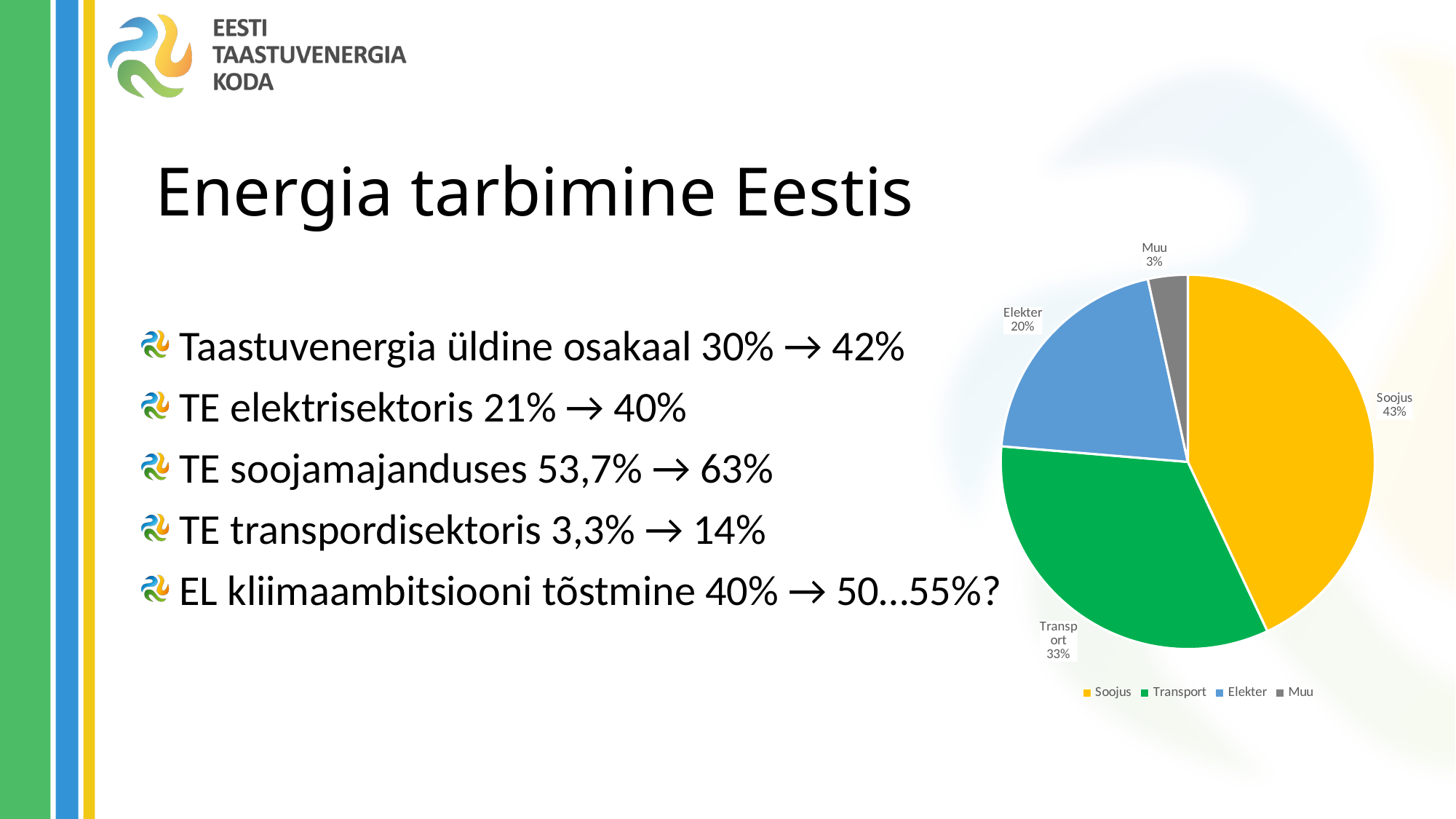
What colour is the Soojus slice in the pie chart? yellow Which category has the smallest slice of the pie? Muu Which category has the largest slice of the pie? Soojus What share of the pie does Soojus have? 43% What share of the pie does Muu have? 3% How many slices does the pie chart have? 4 How many entries does the legend list? 4 What share of the pie does Elekter have? 20% Which is larger, the share for Elekter or the share for Transport? Transport What is the difference in percentage points between Soojus and Transport? 10 What type of chart is shown on the slide? pie chart